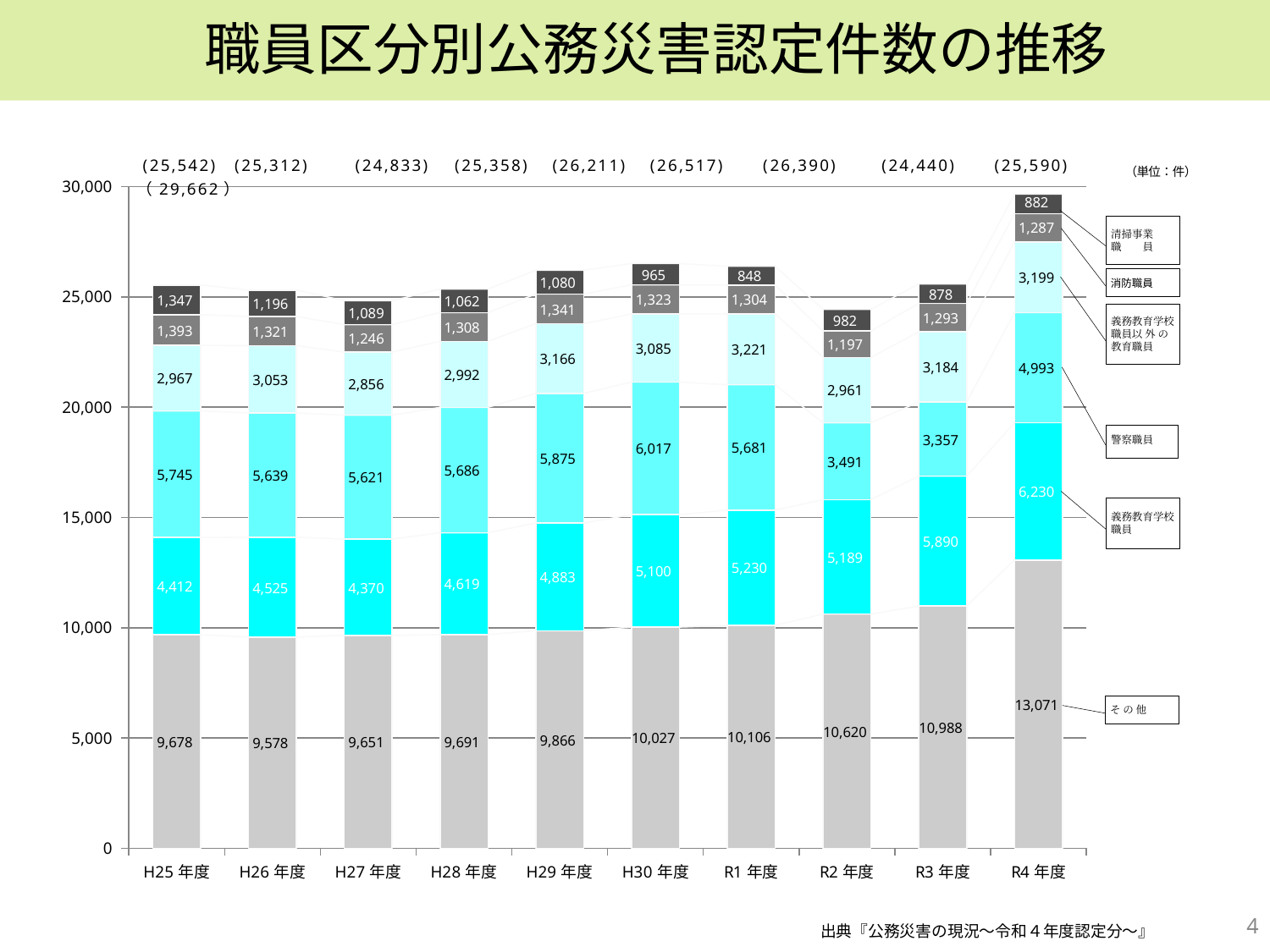
Which is larger, the 警察職員 value for H30年度 or for R1年度? H30年度 What is the title of the chart? 職員区分別公務災害認定件数の推移 What is the value for 消防職員 in R4年度? 1,287 What is the value for その他 in R4年度? 13,071 How many fiscal years are plotted on the x axis? 10 What is the difference between the その他 values for R4年度 and R3年度? 2,083 What kind of chart is shown on the slide? Stacked bar chart What is the total number of cases for H27年度, as printed above the bar? 24,833 How many staff categories (series) are labelled on the right of the chart? 6 Which fiscal year has the highest total number of cases? R4年度 (29,662) Which fiscal year has the lowest total number of cases? R2年度 (24,440) What is the value for 義務教育学校職員 in H30年度? 5,100